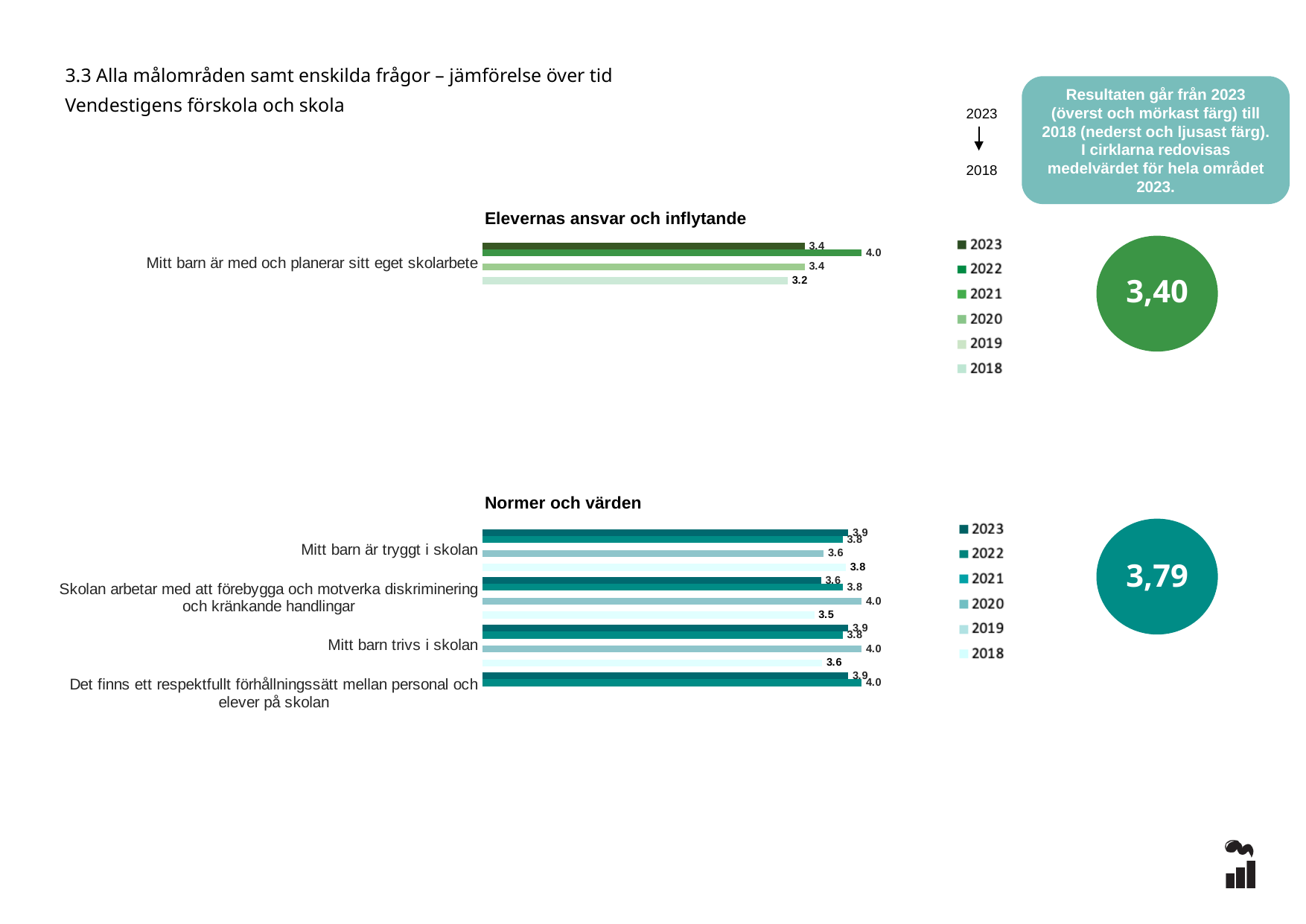
In the 'Normer och värden' chart, what is the 2023 value for 'Mitt barn är tryggt i skolan'? 3.9 In the 'Normer och värden' chart, what is the difference between the 2023 values for 'Mitt barn är tryggt i skolan' and 'Skolan arbetar med att förebygga och motverka diskriminering och kränkande handlingar'? 0.3 In the 'Normer och värden' chart, what is the 2023 value for 'Skolan arbetar med att förebygga och motverka diskriminering och kränkande handlingar'? 3.6 How many years does the legend of the 'Elevernas ansvar och inflytande' chart list? 6 In the 'Normer och värden' chart, what is the lowest value shown for 'Skolan arbetar med att förebygga och motverka diskriminering och kränkande handlingar'? 3.5 How many categories (questions) are shown in the 'Normer och värden' chart? 4 What mean value for 2023 is shown in the circle next to the 'Normer och värden' chart? 3,79 In the 'Elevernas ansvar och inflytande' chart, what is the 2023 value for 'Mitt barn är med och planerar sitt eget skolarbete'? 3.4 In the 'Elevernas ansvar och inflytande' chart, what is the lowest value shown? 3.2 In the 'Normer och värden' chart, which has the higher 2023 value: 'Mitt barn trivs i skolan' or 'Skolan arbetar med att förebygga och motverka diskriminering och kränkande handlingar'? Mitt barn trivs i skolan In the 'Elevernas ansvar och inflytande' chart, what is the highest value shown? 4.0 What kind of chart is used for 'Normer och värden'? bar chart